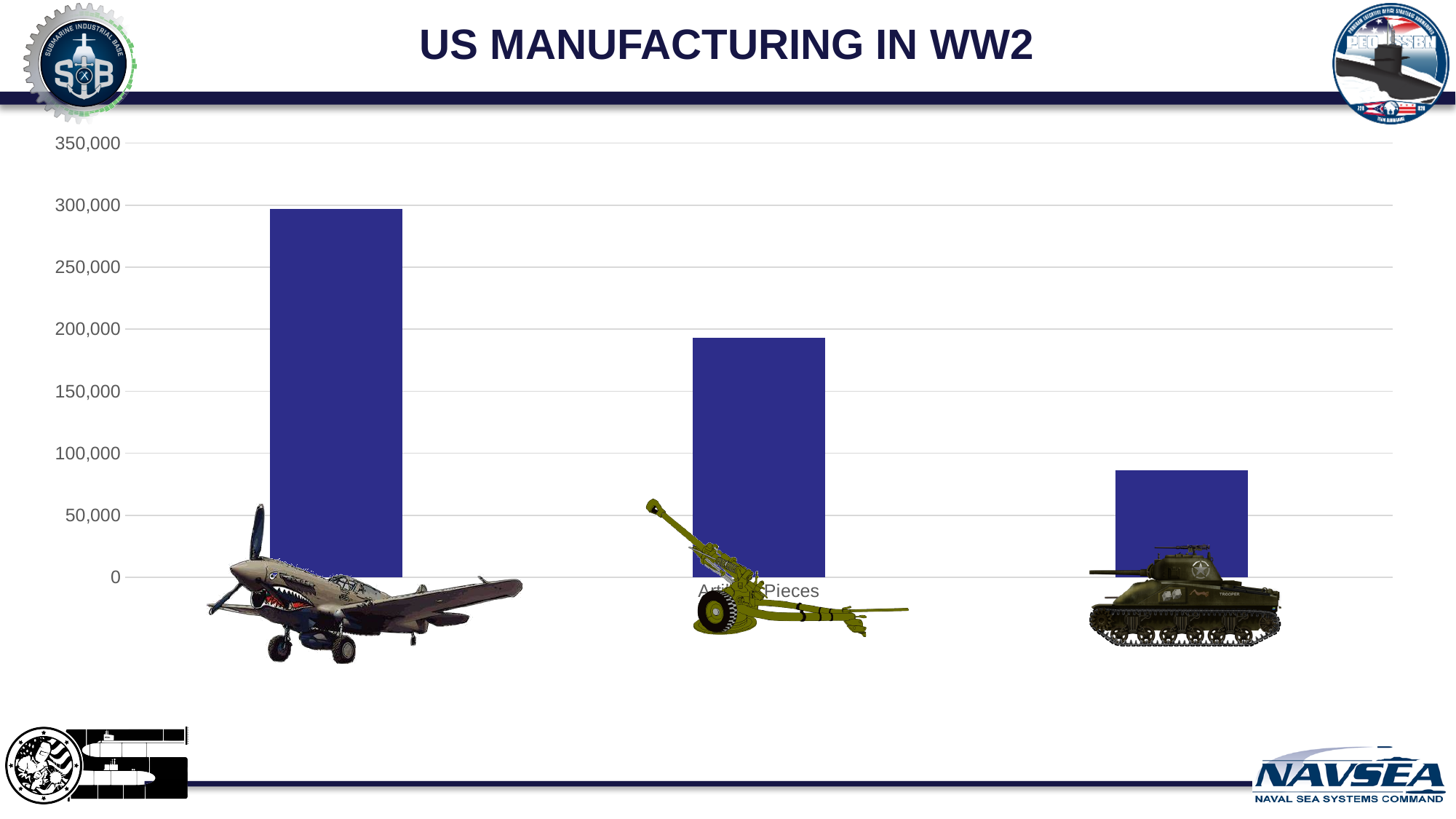
Which bar is the shortest in the chart: the left, middle, or right bar? the right bar Which bar is the tallest in the chart: the left, middle, or right bar? the left bar Is the value for Artillery Pieces greater or less than 150,000? greater What is the title of the slide's chart? US MANUFACTURING IN WW2 Do the bar values rise or fall from left to right across the chart? fall Is the value of the right bar greater or less than 100,000? less Is the value of the right bar greater or less than 50,000? greater How many bars are plotted in the chart? 3 What kind of chart is shown on the slide? bar chart Which is larger: the value for Artillery Pieces or the value of the right bar? Artillery Pieces